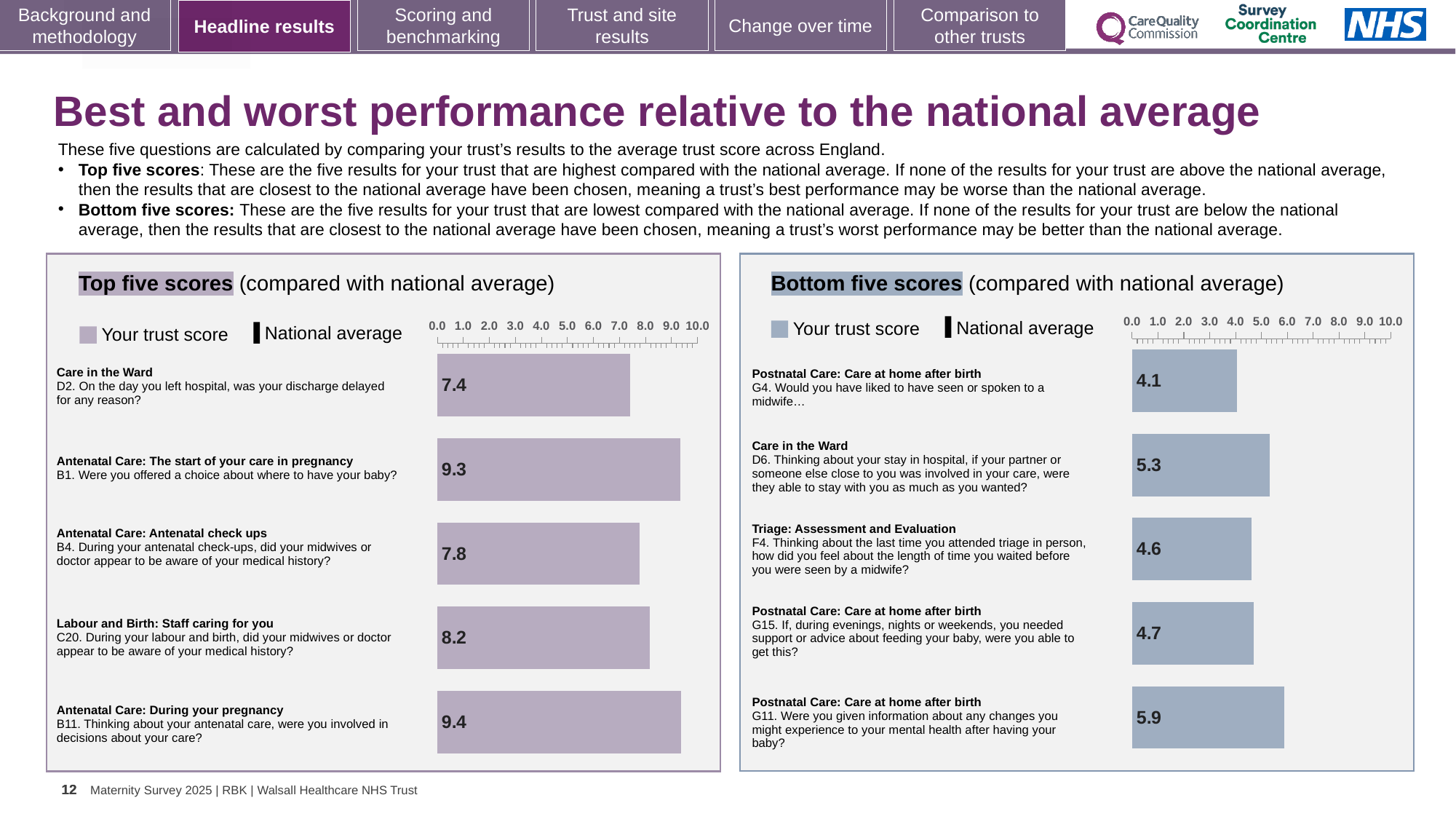
In the Bottom five scores chart, what is the trust score for question G11 about information on changes to your mental health after having your baby? 5.9 In the Bottom five scores chart, what is the trust score for question G4 (Would you have liked to have seen or spoken to a midwife…)? 4.1 In the Top five scores chart, which question has the highest trust score? B11 In the Top five scores chart, what is the trust score for question B1 (Were you offered a choice about where to have your baby?)? 9.3 In the Bottom five scores chart, what is the difference between the trust scores for G11 and G4? 1.8 In the Top five scores chart, what is the difference between the trust scores for B11 and D2? 2.0 How many entries does the legend of the Top five scores chart list? 2 In the Bottom five scores chart, which has the larger trust score, D6 or F4? D6 In the Bottom five scores chart, which question has the lowest trust score? G4 In the Top five scores chart, what is the trust score for question D2 (On the day you left hospital, was your discharge delayed for any reason?)? 7.4 What type of chart is used in the Bottom five scores panel? Bar chart How many bars are shown in the Top five scores chart? 5